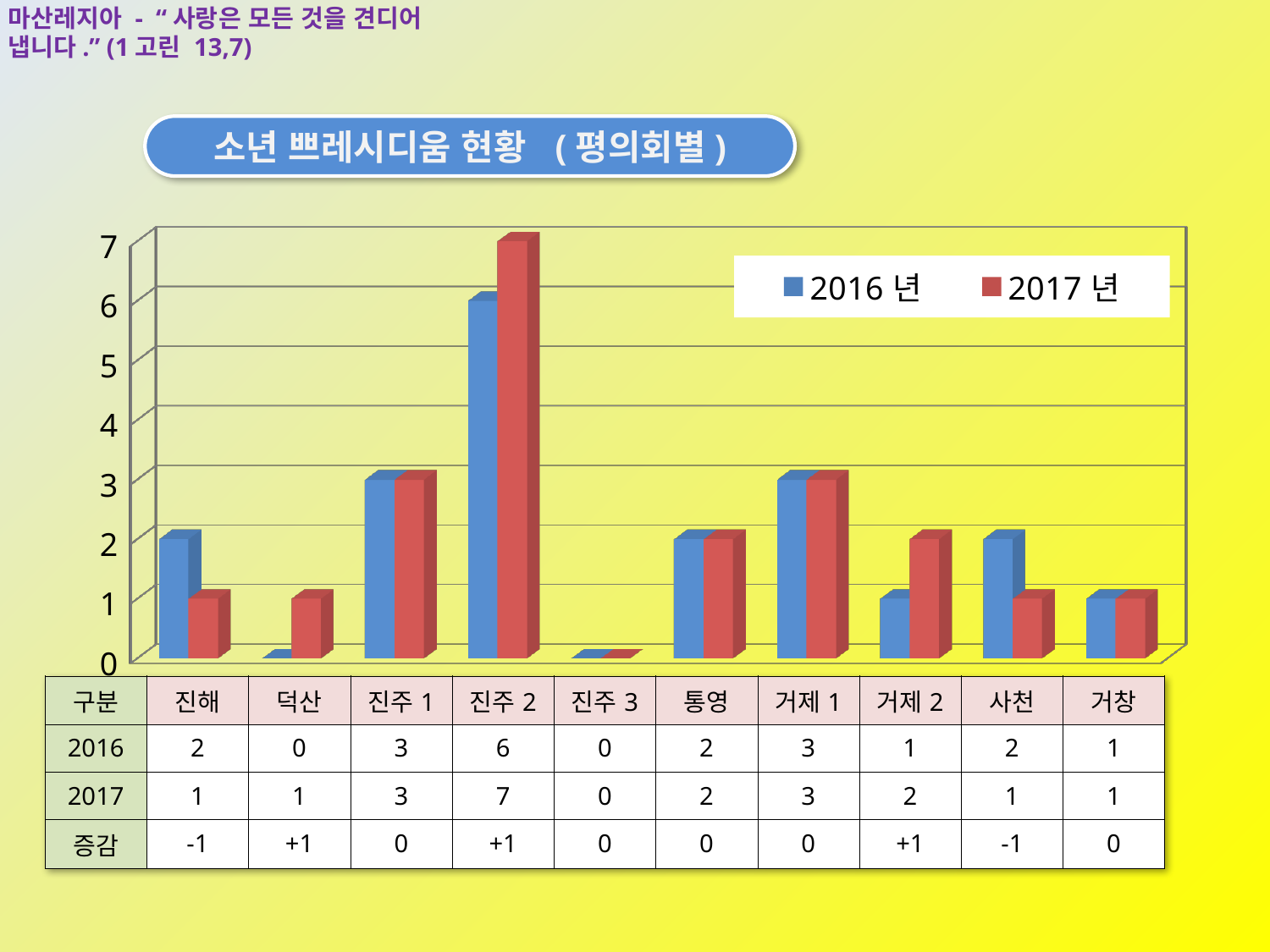
Is the 2017 년 value for 진주 2 greater or less than 5? greater Which category has the lowest 2017 년 value? 진주 3 What type of chart is shown on the slide? bar chart What is the 2017 년 value for 거제 2? 2 How many series does the chart legend list? 2 What is the 2016 년 value for 진주 2? 6 What colour are the 2017 년 bars in the chart? red How many categories are plotted along the x axis of the chart? 10 What is the difference between the 2017 년 and 2016 년 values for 진주 2? 1 Which is larger for 진해, the 2016 년 value or the 2017 년 value? 2016 년 What is the 2017 년 value for 덕산? 1 Which category has the highest 2017 년 value? 진주 2